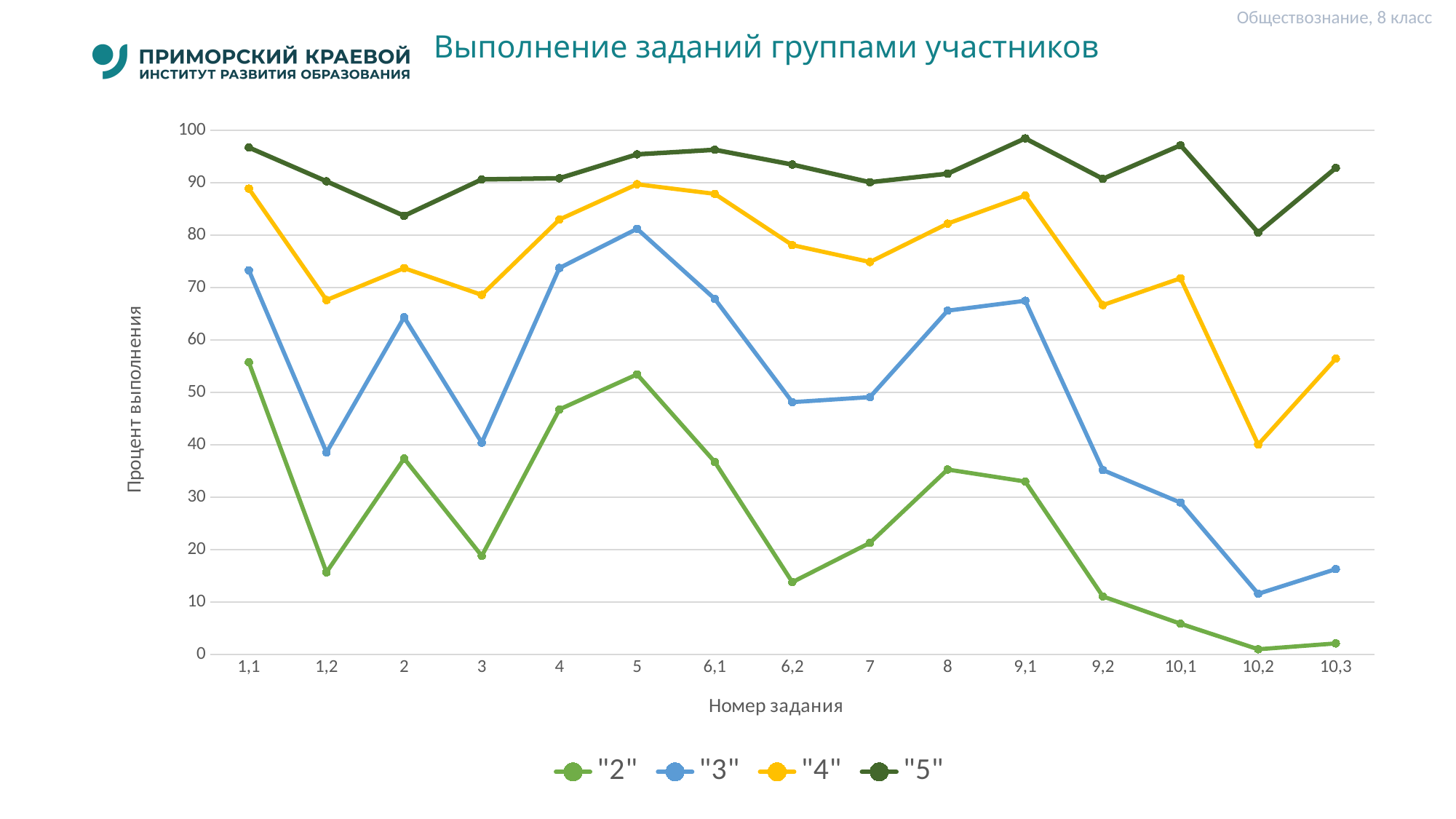
Is the value for series "2" at task 1,1 greater or less than 50? greater At task 1,2, which series has the higher value, "4" or "3"? "4" What is the title of the chart? Выполнение заданий группами участников Is the value for series "4" at task 10,2 greater or less than 50? less For series "4", at which task number is the value lowest? 10,2 Is the value for series "3" at task 10,2 greater or less than 20? less For series "3", at which task number is the value highest? 5 What is the label of the vertical axis? Процент выполнения How many series does the legend list? 4 What kind of chart is shown on the slide? line chart How many task numbers are shown along the x axis? 15